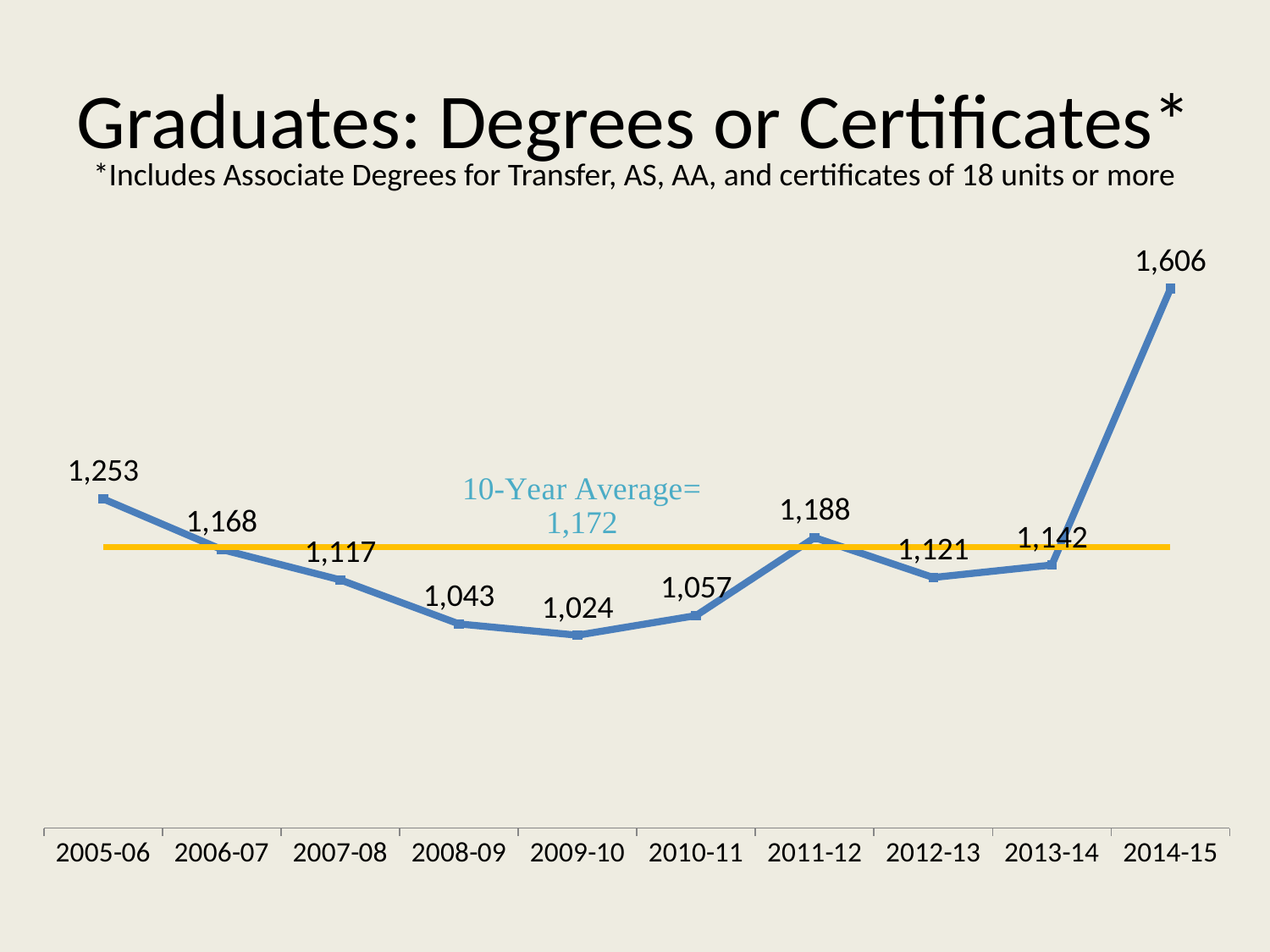
Which year has more graduates, 2012-13 or 2013-14? 2013-14 What is the 10-year average shown on the chart? 1,172 What is the number of graduates for 2014-15? 1,606 How many years are plotted on the chart? 10 What is the number of graduates for 2009-10? 1,024 Do the graduate numbers rise or fall from 2005-06 to 2009-10? Fall What is the difference in graduates between 2005-06 and 2006-07? 85 Which year has the highest number of graduates? 2014-15 What is the number of graduates for 2011-12? 1,188 What kind of chart is shown on the slide? Line chart Which year has the lowest number of graduates? 2009-10 What is the difference in graduates between 2014-15 and 2013-14? 464